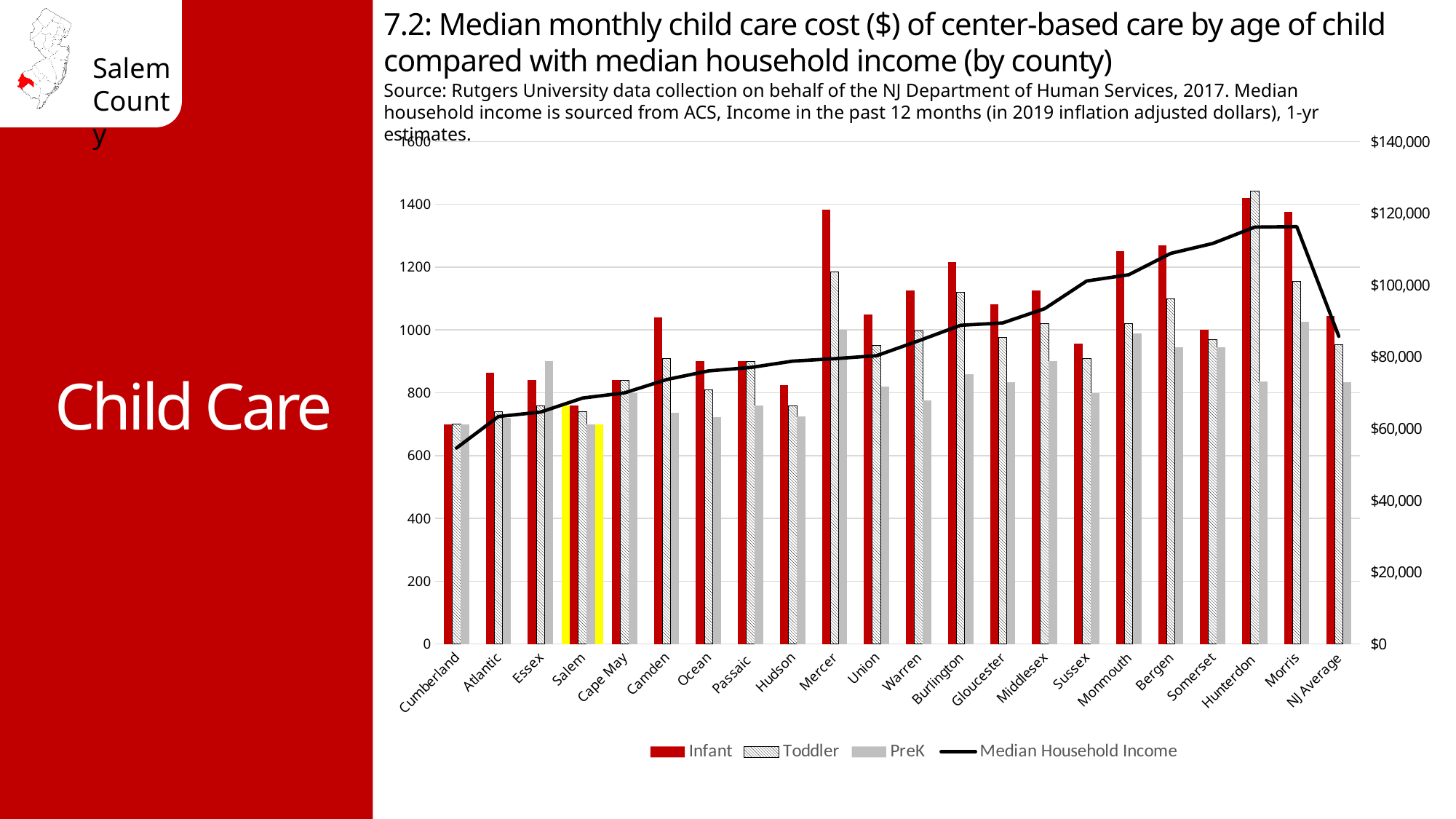
Which county has the highest Infant bar? Hunterdon Which county has the lowest Infant bar? Cumberland How many series does the legend list? 4 Is the Infant value for Salem greater or less than 800? less Which county has the highest Toddler bar? Hunterdon Which county's bars are highlighted in yellow? Salem Is the Median Household Income for Morris greater or less than $100,000? greater Is the Infant value for Mercer greater or less than 1200? greater Does the Median Household Income line generally rise or fall from Cumberland to Morris? rise What kind of chart is shown on the slide? Bar chart with a line Which is larger, the Infant value for Mercer or the Infant value for Camden? Mercer How many categories are shown along the x axis? 22